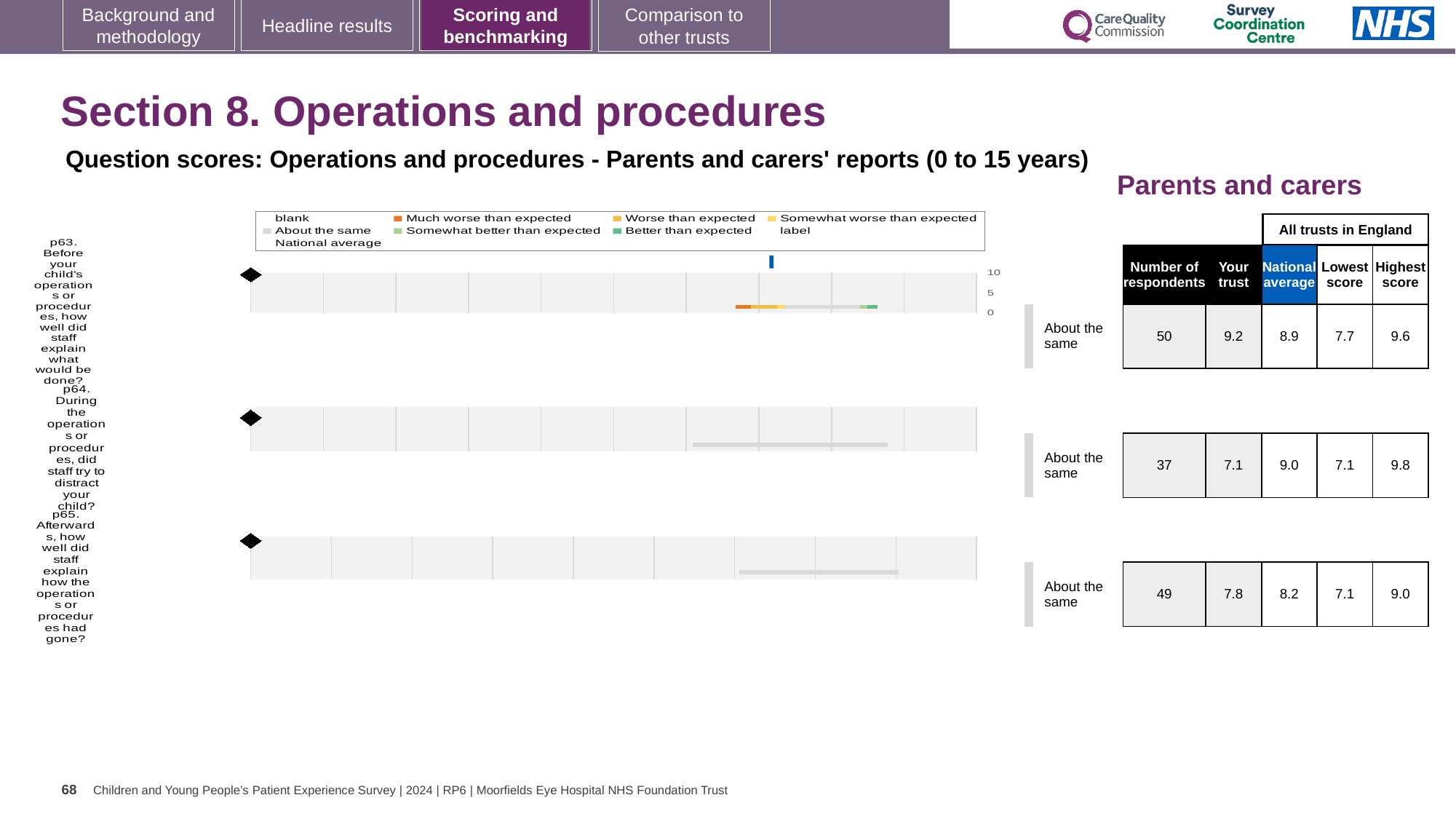
What is the highest tick value shown on the axis of the top chart (p63)? 10 In the table beside the charts, which of the three questions has the lowest 'Your trust' score? p64 Which legend entry is shown in orange? Much worse than expected In the table beside the charts, what is the national average for p64 (During the operations or procedures, did staff try to distract your child?)? 9.0 What benchmark category is shown next to each of the three charts? About the same How many questions (p63, p64, p65) are plotted as separate charts on this slide? 3 In the table beside the charts, what is the 'Your trust' score for p63 (Before your child's operations or procedures, how well did staff explain what would be done?)? 9.2 In the table beside the charts, which of the three questions has the highest 'Your trust' score? p63 What kind of chart is used to show the question scores on this slide? bar chart In the table beside the charts, is the 'Your trust' score for p65 larger or smaller than the national average for p65? smaller In the table beside the charts, what is the difference between the national average and the 'Your trust' score for p64? 1.9 In the table beside the charts, how many respondents answered p65 (Afterwards, how well did staff explain how the operations or procedures had gone?)? 49